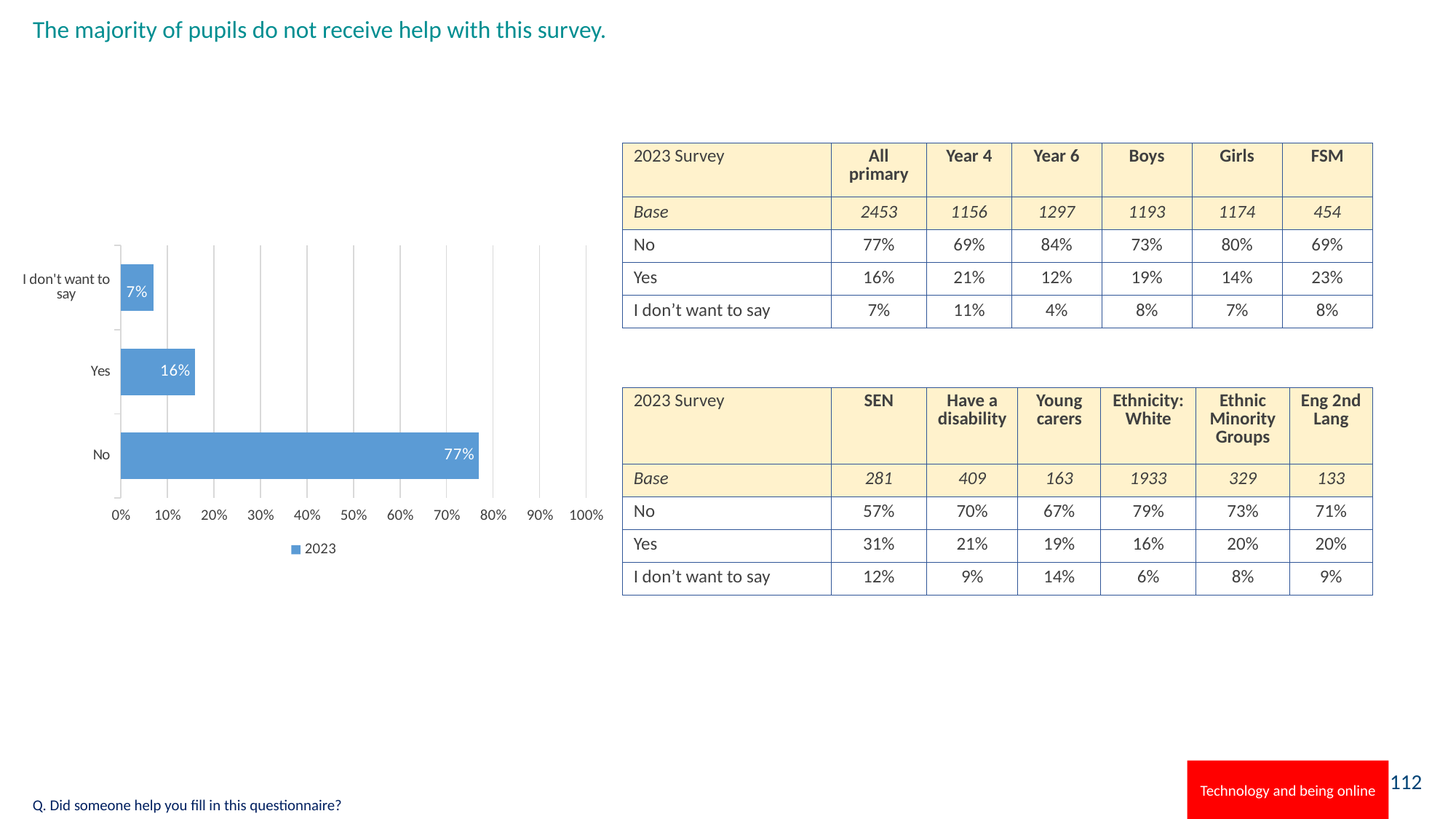
What kind of chart is shown on the slide? Bar chart What is the difference between the values for "Yes" and "I don't want to say" in the bar chart? 9% Is the value for "No" in the bar chart greater or less than 50%? greater How many series does the legend of the bar chart list? 1 Which is larger in the bar chart, the value for "Yes" or the value for "I don't want to say"? Yes Which category has the lowest value in the bar chart? I don't want to say What is the difference between the values for "No" and "Yes" in the bar chart? 61% What is the value for "Yes" in the bar chart? 16% Which category has the highest value in the bar chart? No How many categories are shown in the bar chart? 3 What is the value for "No" in the bar chart? 77% What is the value for "I don't want to say" in the bar chart? 7%